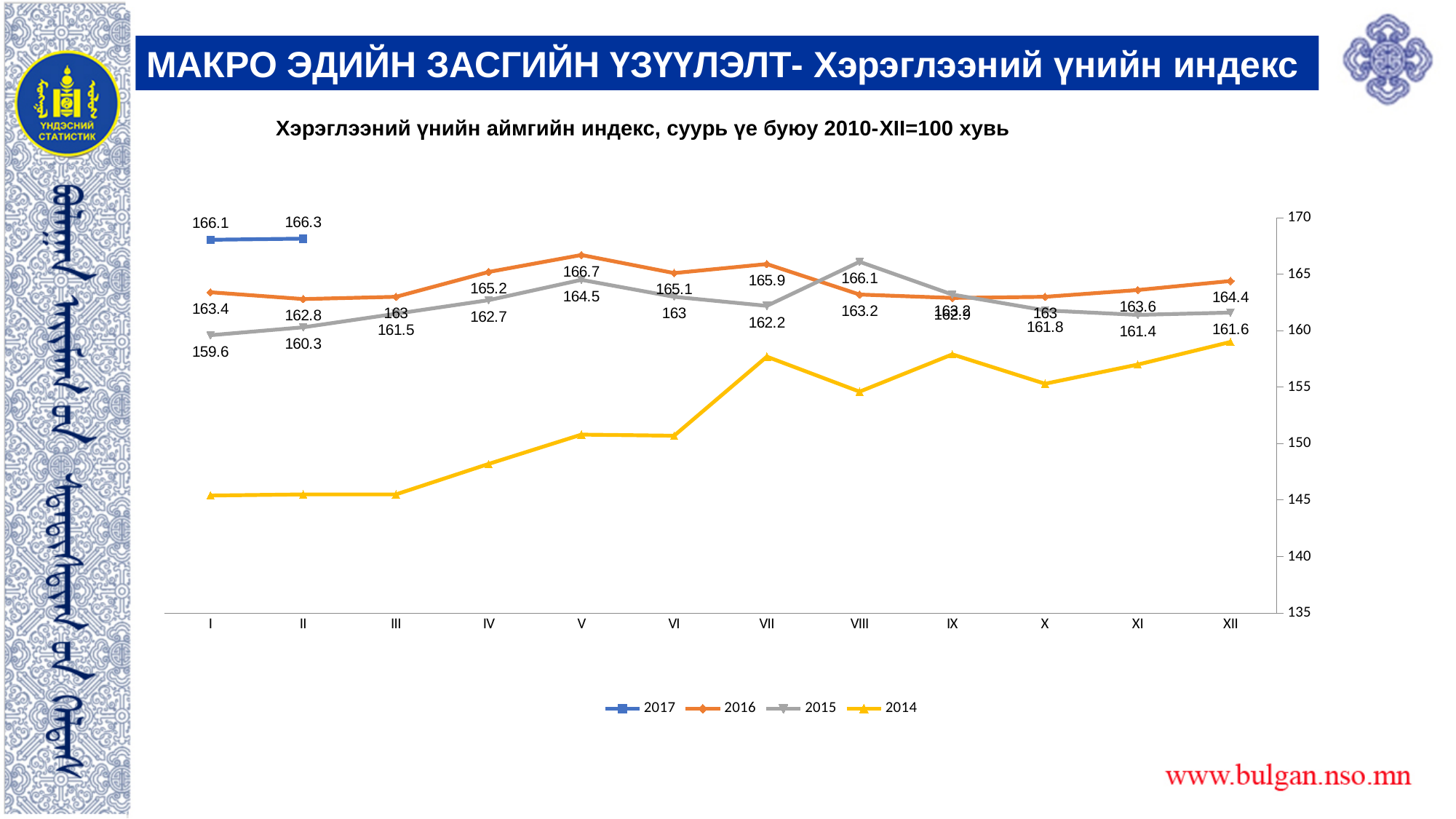
How many series does the legend list? 4 What is the value for 2015 in month I? 159.6 In which month does the 2015 series have its lowest value? I What is the value for 2017 in month II? 166.3 Is the value for 2014 in month I greater or less than 150? less How many months are shown on the x axis? 12 In which month does the 2016 series reach its highest value? V In month VIII, which series has the larger value, 2016 or 2015? 2015 What kind of chart is shown on the slide? line chart Does the 2014 series generally rise or fall from month I to month XII? rise What is the value for 2016 in month V? 166.7 What is the difference between the 2017 values for month II and month I? 0.2